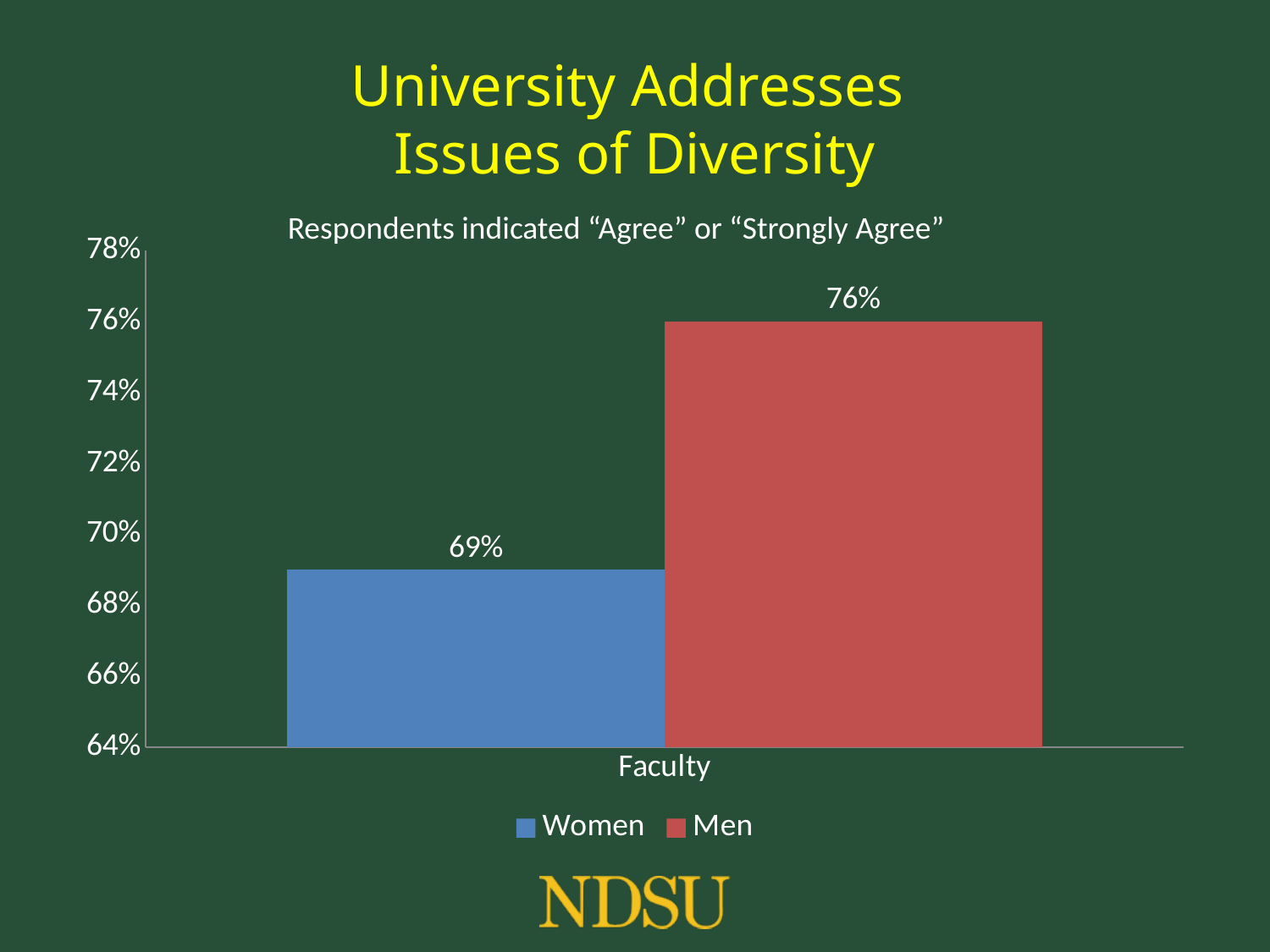
What percentage of women faculty agreed or strongly agreed that the university addresses issues of diversity? 69% Which group has the lower value, Women or Men? Women Is the value for Men greater or less than 74%? greater Which group has the higher value, Women or Men? Men What percentage of men faculty agreed or strongly agreed that the university addresses issues of diversity? 76% What is the category label on the x axis? Faculty Is the value for Women greater or less than 70%? less Which colour represents Men in the chart? Red How many categories are shown on the x axis? 1 What kind of chart is shown on the slide? Bar chart What is the difference between the Men and Women values? 7% How many series does the legend list? 2